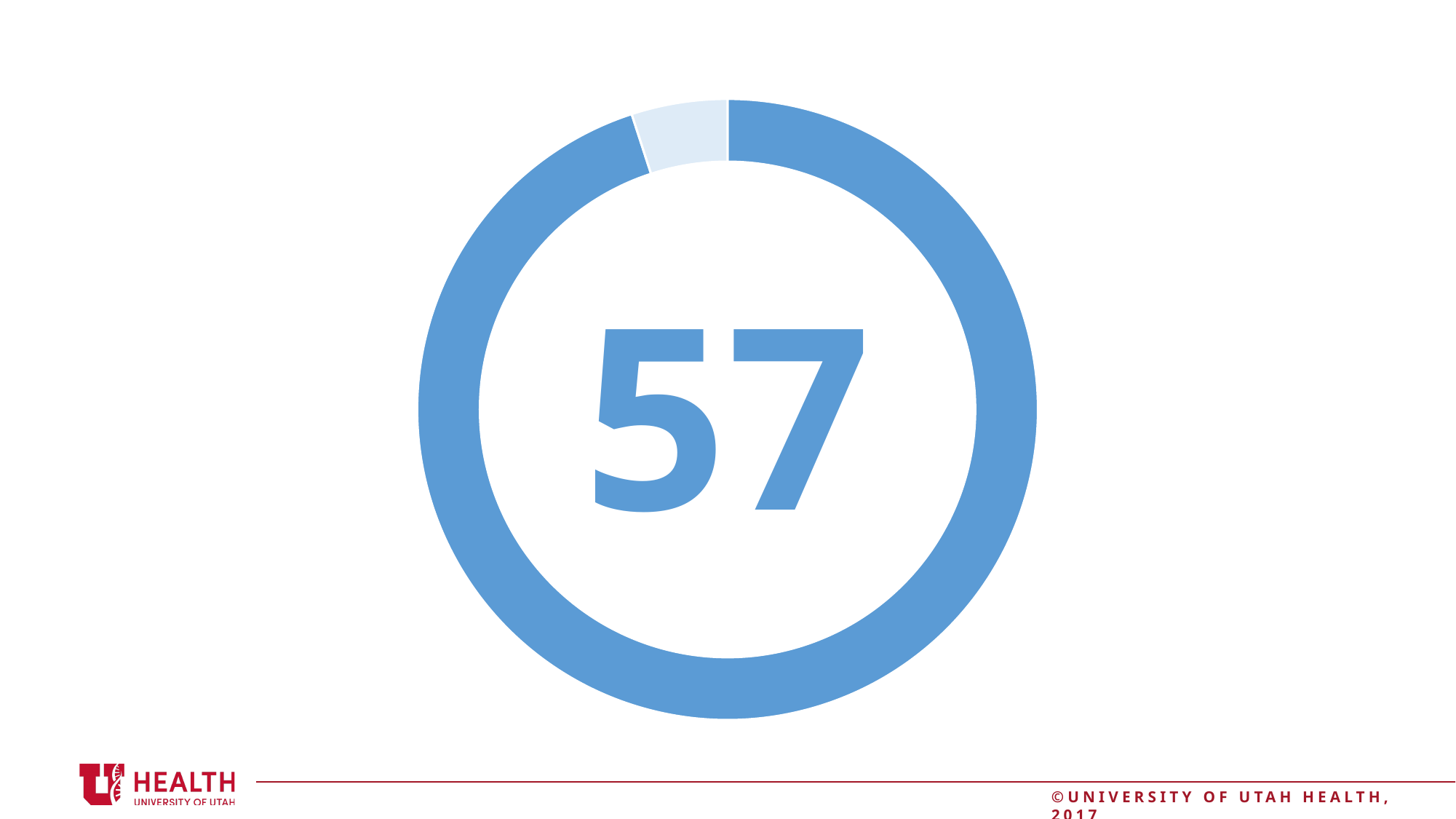
What colour is the largest segment of the doughnut chart? Blue Does the dark blue segment cover more or less than half of the doughnut chart? More How many segments does the doughnut chart have? 2 Which segment of the doughnut chart is the smallest? The light blue segment Which segment of the doughnut chart is larger, the dark blue one or the light blue one? The dark blue one What number is displayed in the centre of the doughnut chart? 57 What kind of chart is shown on the slide? Doughnut chart